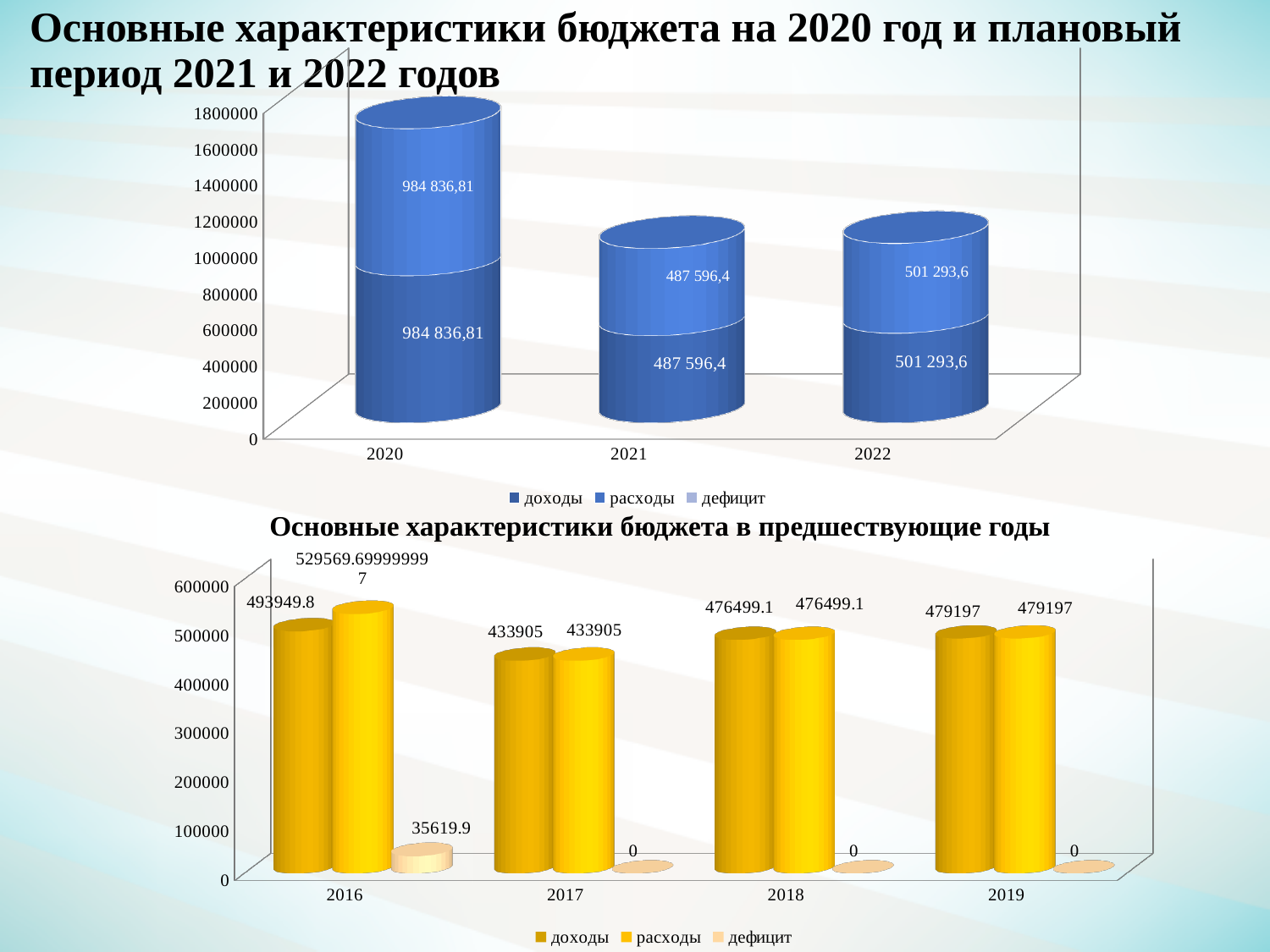
In the top chart, what is the difference between расходы for 2022 and расходы for 2021? 13 697,2 In the top chart, what is the value of доходы for 2020? 984 836,81 In the bottom chart, which year has the lowest доходы? 2017 In the top chart, which year has the highest доходы? 2020 In the top chart, which year has the lowest расходы? 2021 In the bottom chart, what is the difference between доходы for 2019 and доходы for 2018? 2697.9 In the bottom chart, what is the value of дефицит for 2016? 35619.9 In the top chart, what is the value of расходы for 2022? 501 293,6 In the bottom chart, how many years are shown on the x axis? 4 In the top chart, how many series does the legend list? 3 In the bottom chart, which year has the highest расходы? 2016 In the bottom chart, what is the value of доходы for 2016? 493949.8